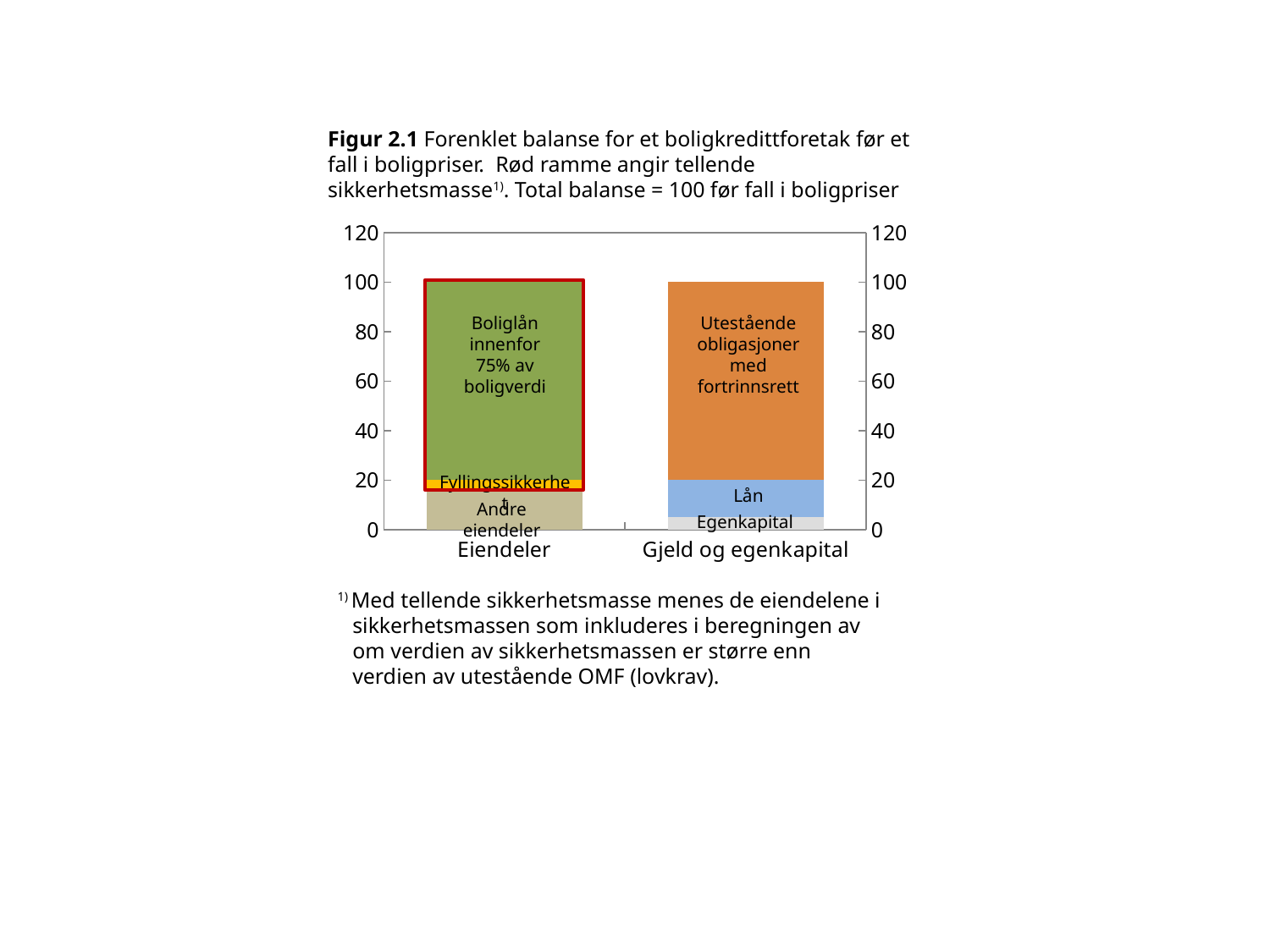
Which segment is the largest in the Eiendeler bar? Boliglån innenfor 75% av boligverdi Is the value of the Lån segment greater or less than 20? less Which segment is the smallest in the Gjeld og egenkapital bar? Egenkapital According to the title, what does the red frame around part of the Eiendeler bar indicate? Tellende sikkerhetsmasse How many bars (categories) are shown on the x axis? 2 Is the value of the Boliglån innenfor 75% av boligverdi segment greater or less than 60? greater What is the total height of the Gjeld og egenkapital bar? 100 Which is larger: the Boliglån innenfor 75% av boligverdi segment or the Lån segment? Boliglån innenfor 75% av boligverdi What are the two categories on the x axis? Eiendeler; Gjeld og egenkapital What kind of chart is shown on the slide? Stacked bar chart What is the total height of the Eiendeler bar? 100 Is the value of the Utestående obligasjoner med fortrinnsrett segment greater or less than 60? greater